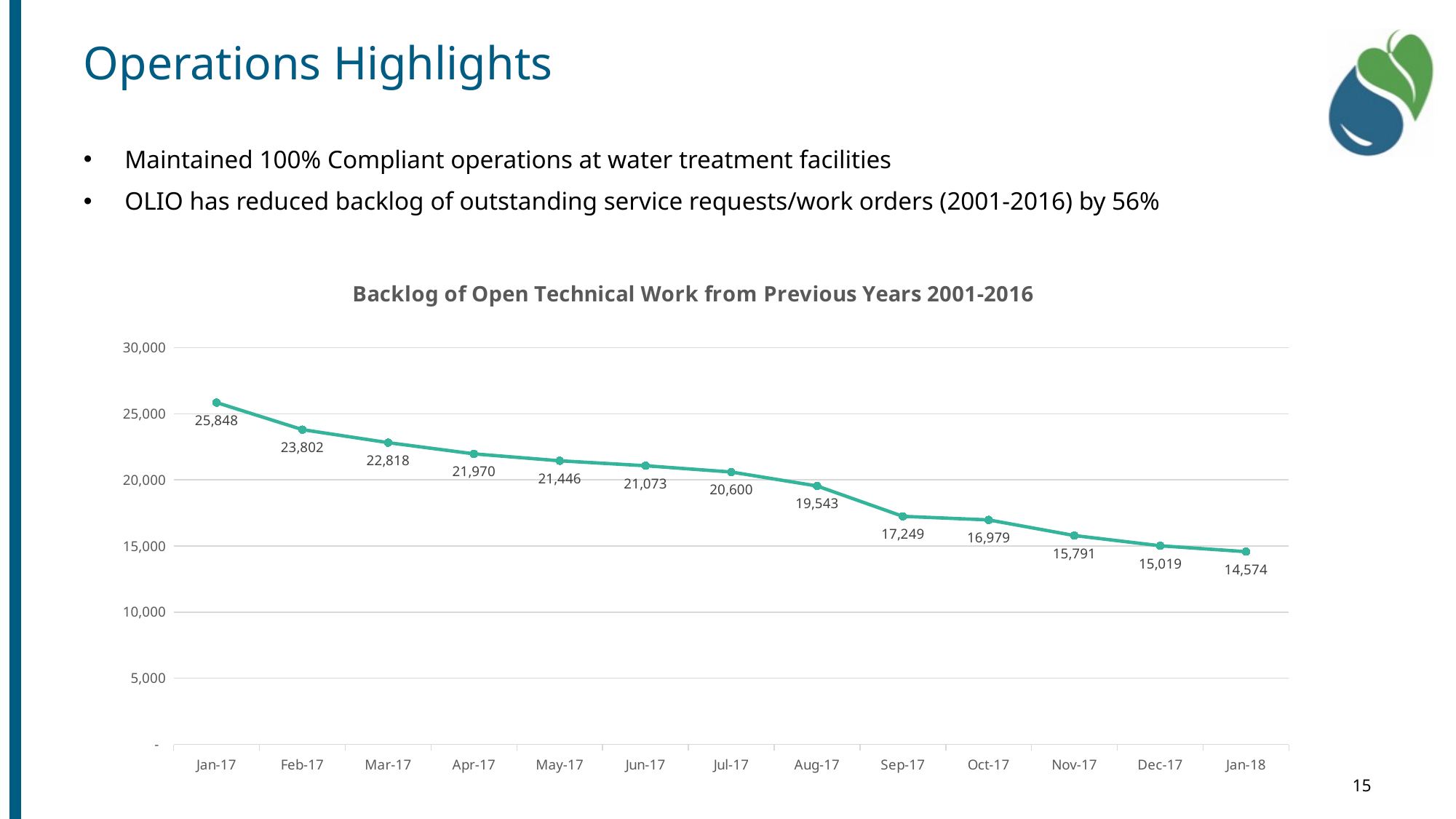
How many data points are plotted on the chart? 13 What kind of chart is shown on the slide? Line chart Which is larger, the backlog in Mar-17 or in Jun-17? Mar-17 What is the backlog value for Jan-18? 14,574 Which month has the highest backlog value? Jan-17 What is the backlog value for Aug-17? 19,543 Is the backlog value for Jul-17 greater or less than 20,000? greater Which month has the lowest backlog value? Jan-18 Do the backlog values rise or fall from Jan-17 to Jan-18? Fall What is the backlog value for Jan-17? 25,848 What is the difference between the backlog in Aug-17 and Sep-17? 2,294 What is the difference between the backlog in Jan-17 and Jan-18? 11,274